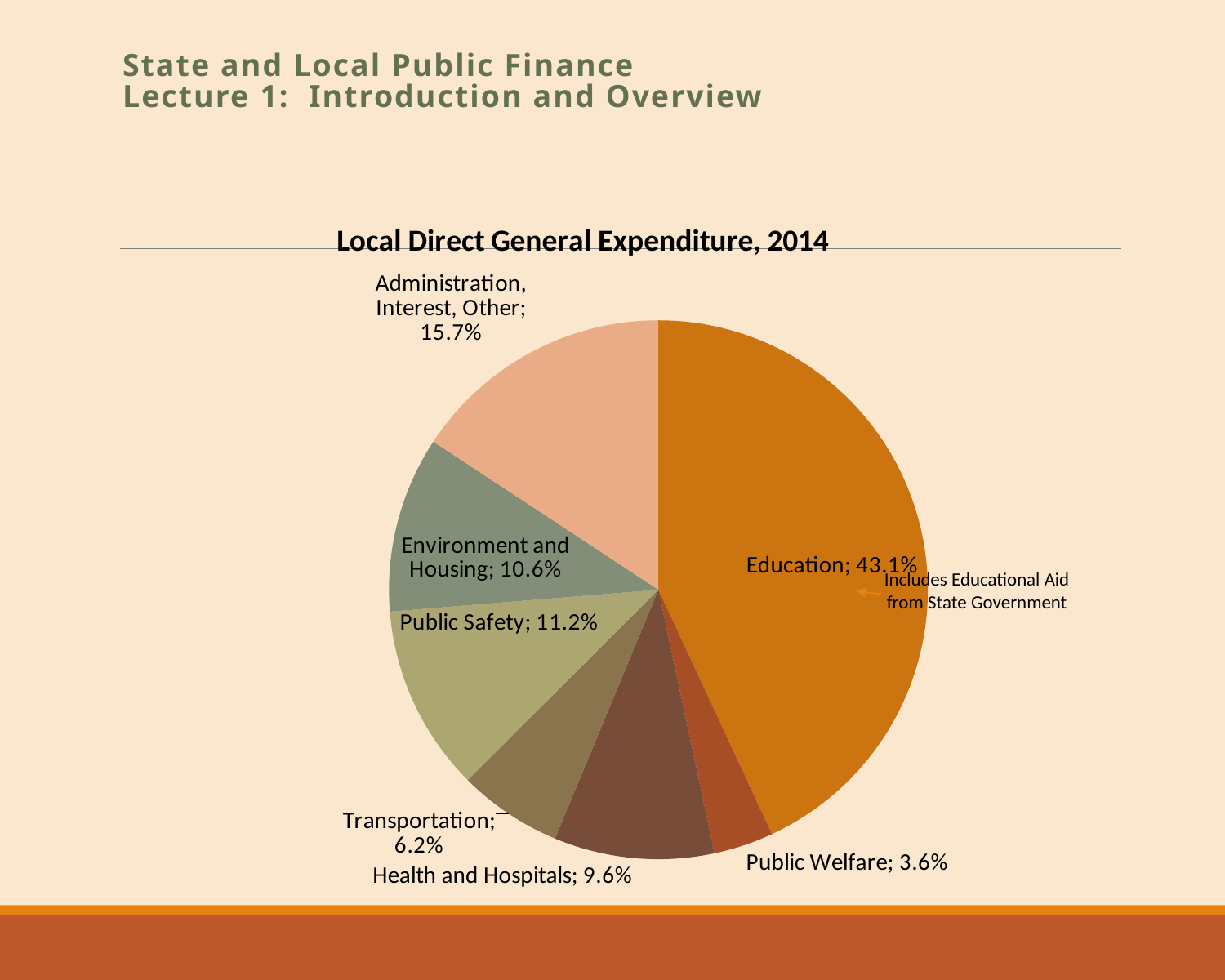
What share of local direct general expenditure goes to Education? 43.1% What kind of chart is shown on the slide? Pie chart How many categories are shown in the pie chart? 7 Which is larger, the share for Transportation or the share for Health and Hospitals? Health and Hospitals What is the title of the chart? Local Direct General Expenditure, 2014 What percentage is shown for Health and Hospitals? 9.6% Which category has the smallest share of the pie? Public Welfare What is the difference in percentage points between Education and Administration, Interest, Other? 27.4 Which category has the largest share of the pie? Education What percentage is shown for Administration, Interest, Other? 15.7% What percentage is shown for Public Safety? 11.2% What percentage is shown for Environment and Housing? 10.6%